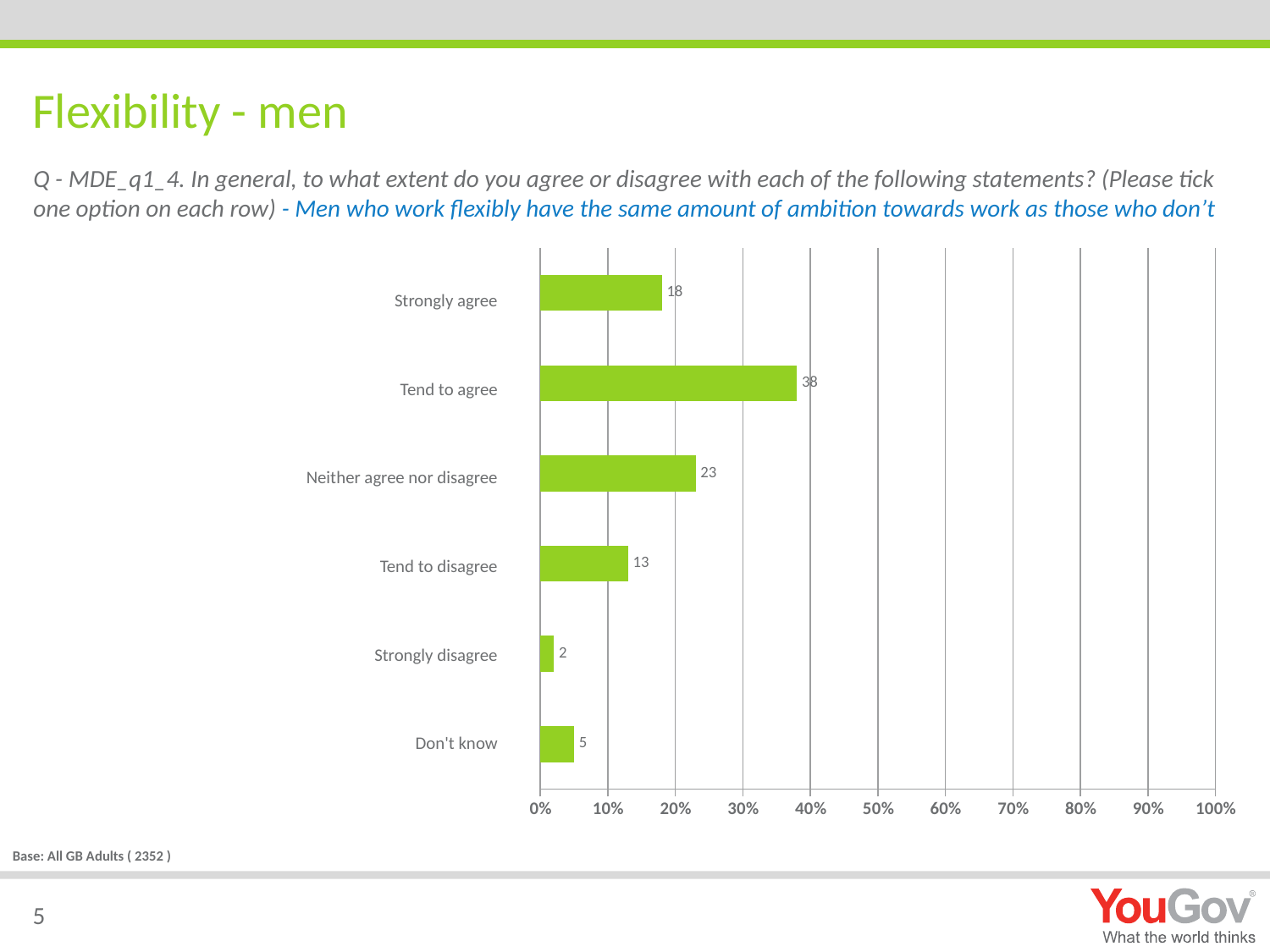
Which category has the lowest value? Strongly disagree What is the value for Don't know? 5 What kind of chart is shown on the slide? bar chart Which is larger, the value for Neither agree nor disagree or the value for Tend to disagree? Neither agree nor disagree Is the value for Tend to agree greater or less than 30%? greater How many categories are shown in the chart? 6 What is the difference between the values for Tend to agree and Strongly agree? 20 What is the value for Neither agree nor disagree? 23 What is the title of the slide? Flexibility - men What is the value for Tend to agree? 38 What is the value for Strongly agree? 18 Which category has the highest value? Tend to agree